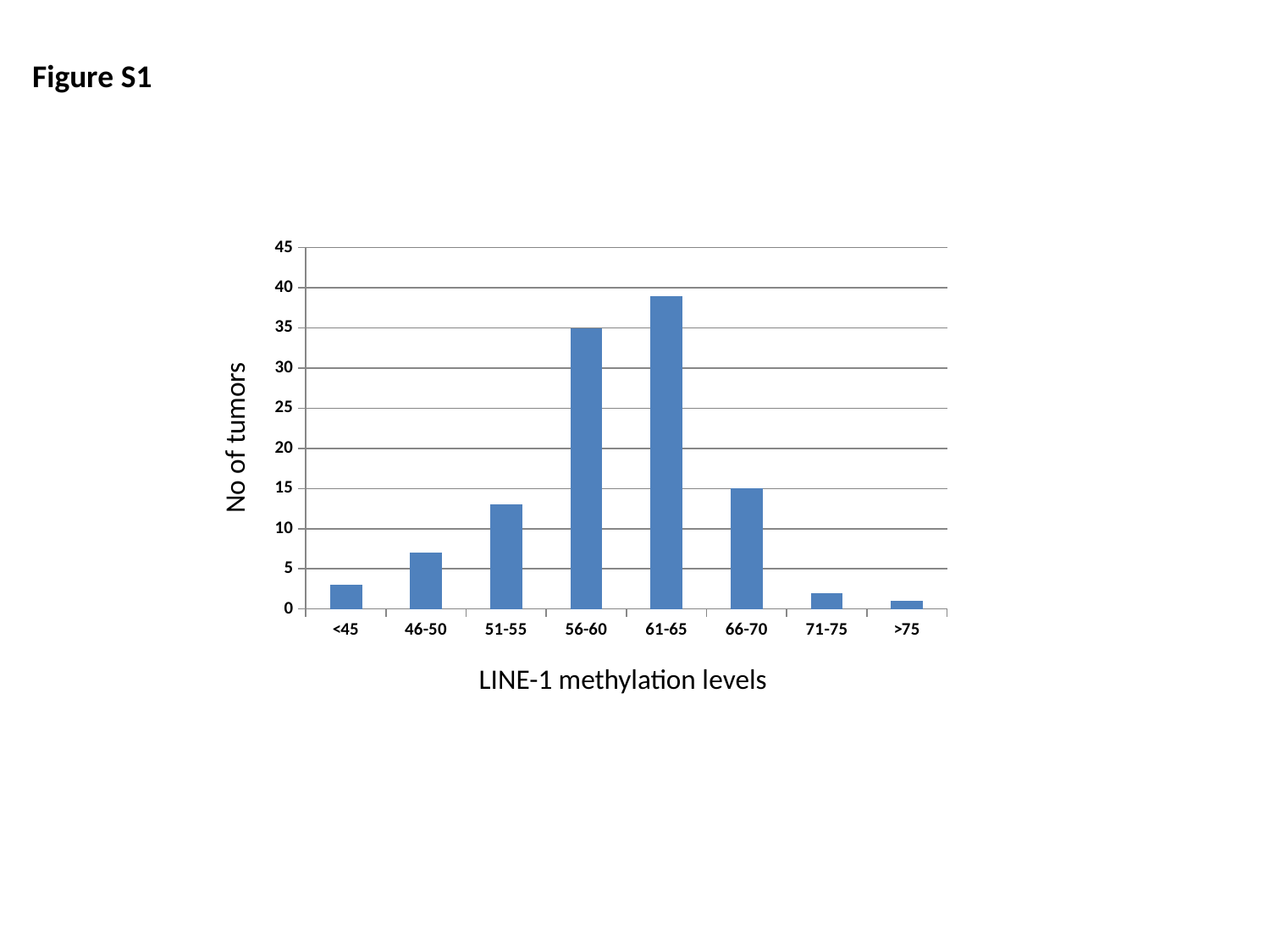
How many LINE-1 methylation level categories are shown on the x axis? 8 What is the difference in the number of tumors between the 56-60 and 66-70 categories? 20 Is the number of tumors for the 61-65 category greater or less than 35? greater Is the number of tumors for the 51-55 category greater or less than 10? greater What is the number of tumors for the 66-70 category? 15 Which LINE-1 methylation level category has the highest number of tumors? 61-65 Is the number of tumors for the <45 category greater or less than 5? less Which has more tumors, the 46-50 category or the 66-70 category? 66-70 What kind of chart is shown on the slide? bar chart Which LINE-1 methylation level category has the lowest number of tumors? >75 What is the label of the y axis? No of tumors What is the number of tumors for the 56-60 category? 35